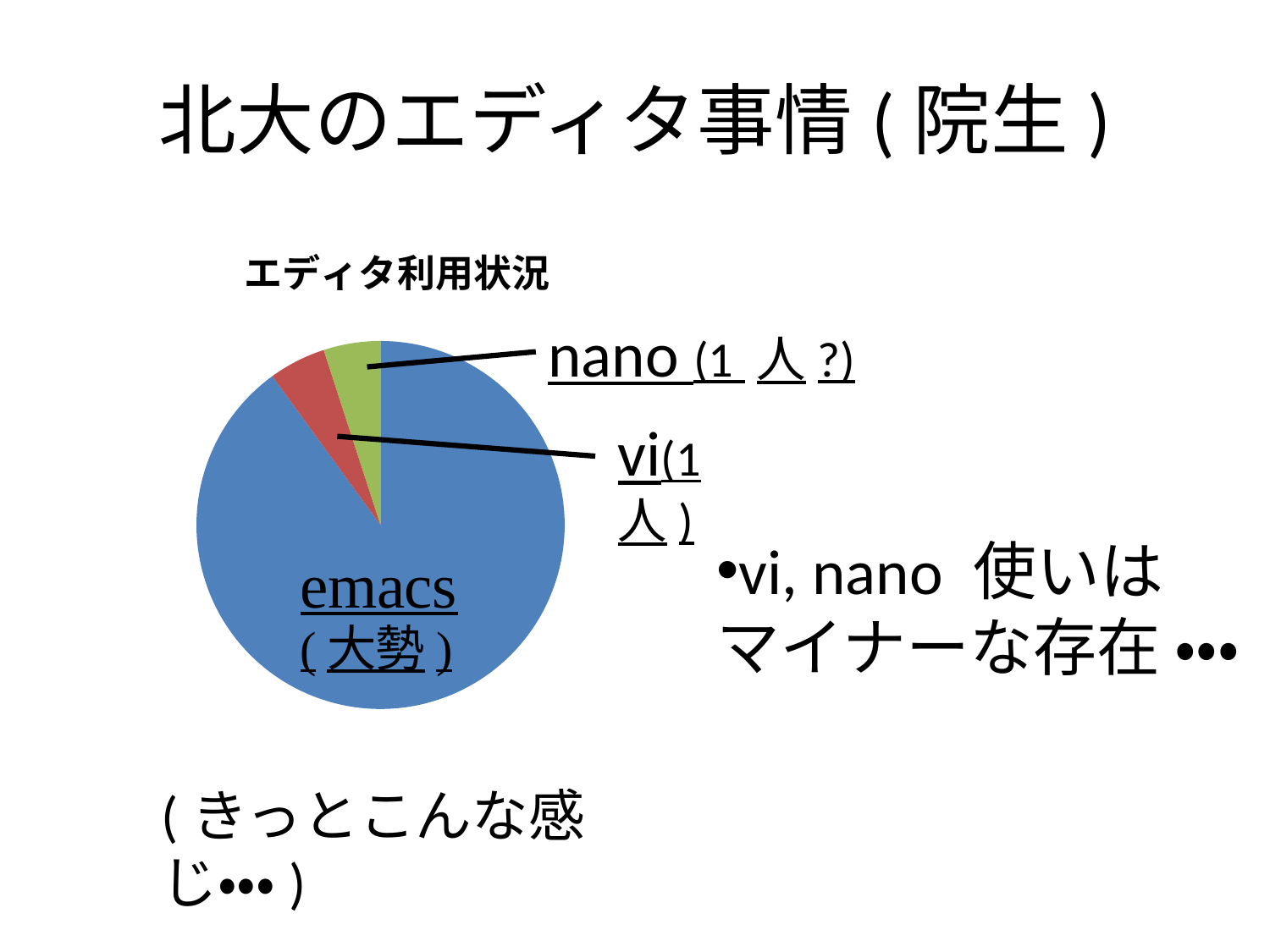
Is the emacs share of the pie greater or less than 50%? greater Which slice is larger, emacs or vi? emacs What number of people is shown in the label for nano? 1 人 ? What is the title of the pie chart? エディタ利用状況 Which editor has the largest slice in the pie chart? emacs What colour is the emacs slice? blue What word describes the emacs slice in its label? 大勢 Is the nano share of the pie greater or less than 25%? less What number of people is shown in the label for vi? 1 人 What kind of chart is shown on the slide? pie chart How many slices does the pie chart have? 3 Which slice is larger, emacs or nano? emacs